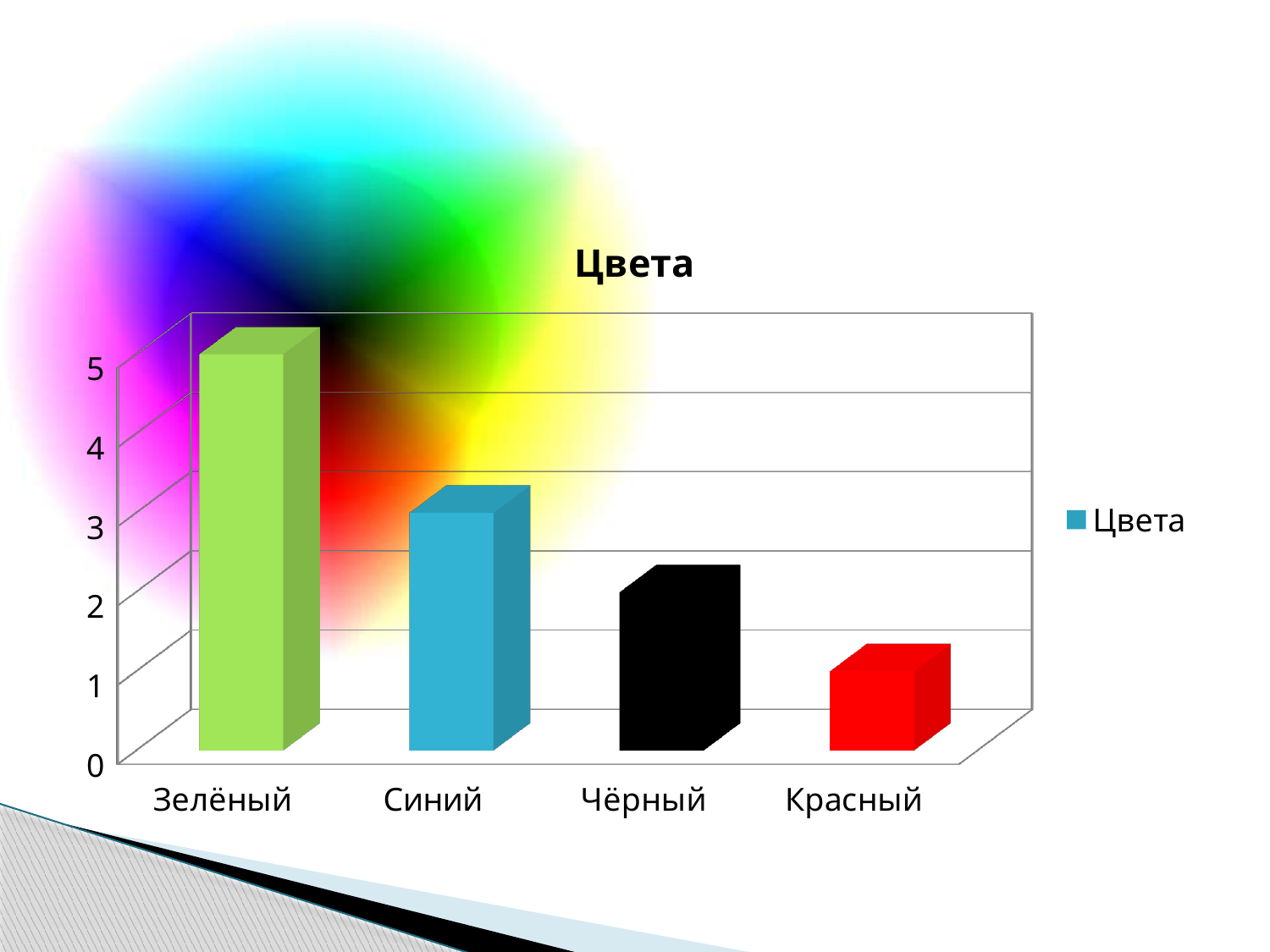
How many categories are shown on the x axis of the chart? 4 What is the title of the chart? Цвета Which category has the lowest bar? Красный Which category has the highest bar? Зелёный What is the name of the series shown in the legend? Цвета Which is larger, the value for Синий or the value for Чёрный? Синий How many series does the legend list? 1 What kind of chart is shown on the slide? bar chart Is the value for Синий greater or less than 4? less Is the value for Красный greater or less than 2? less Do the bar values rise or fall from left to right along the x axis? fall Is the value for Зелёный greater or less than 4? greater